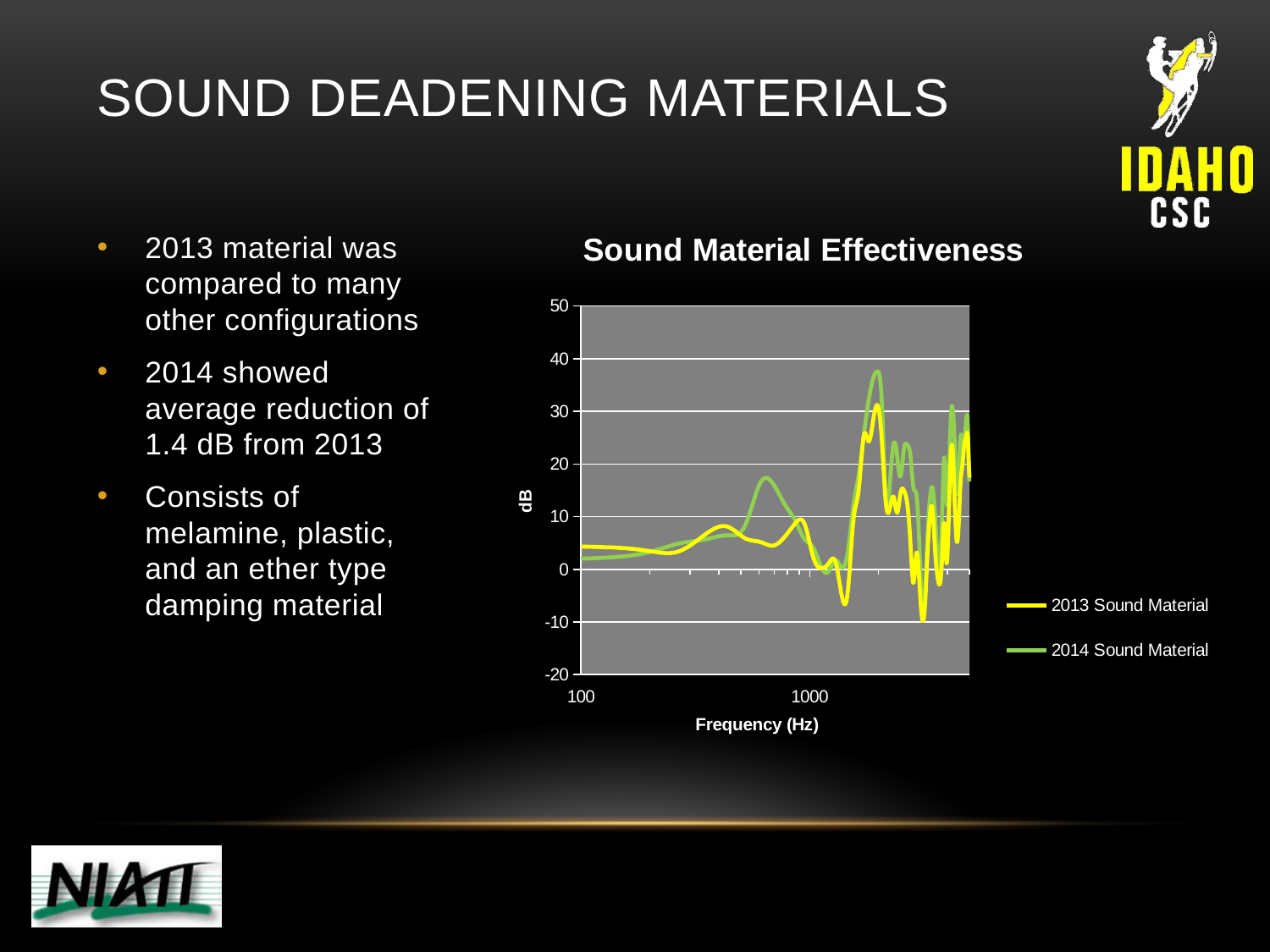
Is the value of the 2014 Sound Material line at 100 Hz greater or less than 10 dB? less Do the values of both lines generally rise or fall from 100 Hz up to their peaks near 2000 Hz? rise What kind of chart is shown on the slide? line chart Which series reaches the higher peak value, 2013 Sound Material or 2014 Sound Material? 2014 Sound Material Is the highest peak of the 2014 Sound Material line greater or less than 30 dB? greater Is the value of the 2013 Sound Material line at 100 Hz greater or less than 10 dB? less What is the title of the chart on the slide? Sound Material Effectiveness How many series does the legend of the Sound Material Effectiveness chart list? 2 What is the label of the x axis of the chart? Frequency (Hz)